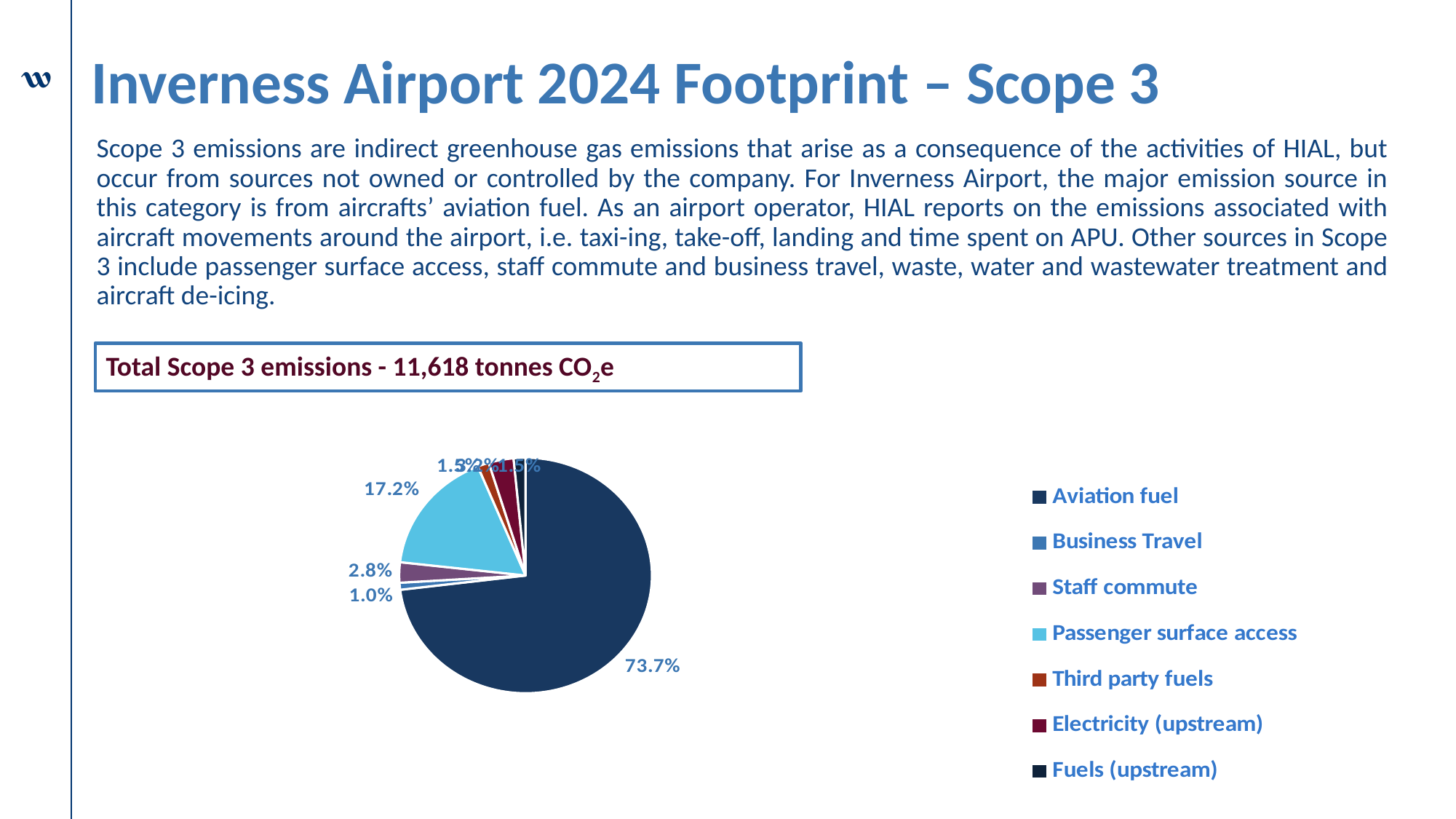
By how many percentage points does the Aviation fuel share exceed the Passenger surface access share? 56.5 percentage points Which slice is larger in the pie chart: Passenger surface access or Staff commute? Passenger surface access How many categories does the legend of the pie chart list? 7 Is the Aviation fuel share of the pie chart greater or less than 50%? greater What colour is the Passenger surface access slice in the pie chart? light blue What percentage is shown for Business Travel in the pie chart? 1.0% What is the difference in percentage points between Passenger surface access and Staff commute? 14.4 percentage points What share of Scope 3 emissions does Aviation fuel account for in the pie chart? 73.7% What percentage is shown for Staff commute in the pie chart? 2.8% Which category has the largest slice of the pie chart? Aviation fuel What kind of chart is shown on the slide? pie chart What share of the pie chart is Passenger surface access? 17.2%